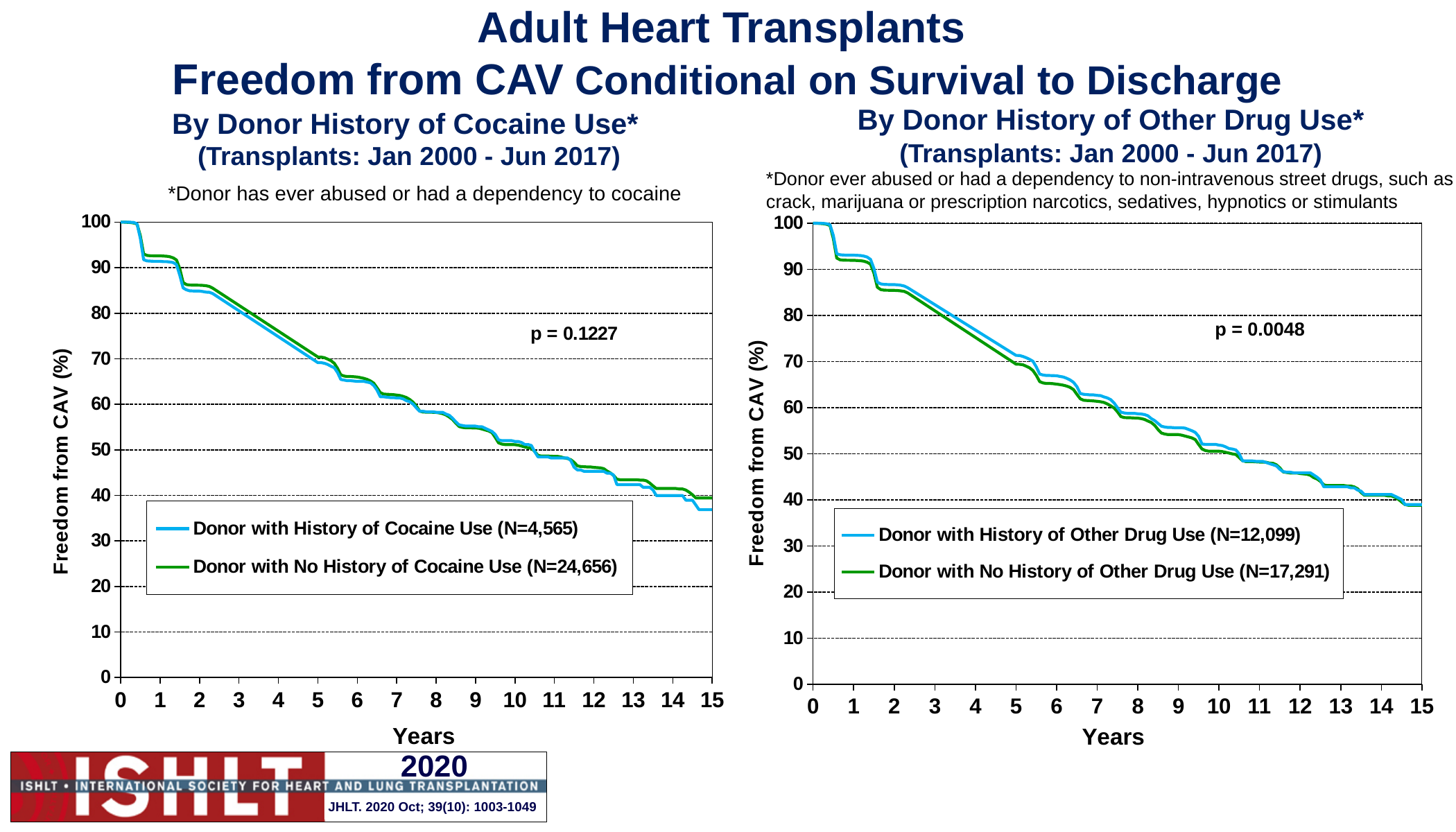
In the left chart, 'By Donor History of Cocaine Use', what is the N for donors with a history of cocaine use? N=4,565 In the left chart, 'By Donor History of Cocaine Use', is the value for donors with a history of cocaine use at year 15 greater or less than 40? less In the left chart, 'By Donor History of Cocaine Use', do the lines rise or fall as years increase? Fall In the left chart, 'By Donor History of Cocaine Use', what is the N for donors with no history of cocaine use? N=24,656 In the right chart, 'By Donor History of Other Drug Use', is the value for donors with a history of other drug use at year 2 greater or less than 80? greater In the right chart, 'By Donor History of Other Drug Use', what is the N for donors with no history of other drug use? N=17,291 What p-value is shown on the left chart, 'By Donor History of Cocaine Use'? p = 0.1227 In the left chart, 'By Donor History of Cocaine Use', which series is higher at year 15? Donor with No History of Cocaine Use What p-value is shown on the right chart, 'By Donor History of Other Drug Use'? p = 0.0048 How many series does the legend of the right chart, 'By Donor History of Other Drug Use', list? 2 In the right chart, 'By Donor History of Other Drug Use', what is the N for donors with a history of other drug use? N=12,099 What kind of chart is the left chart, 'By Donor History of Cocaine Use'? Line chart